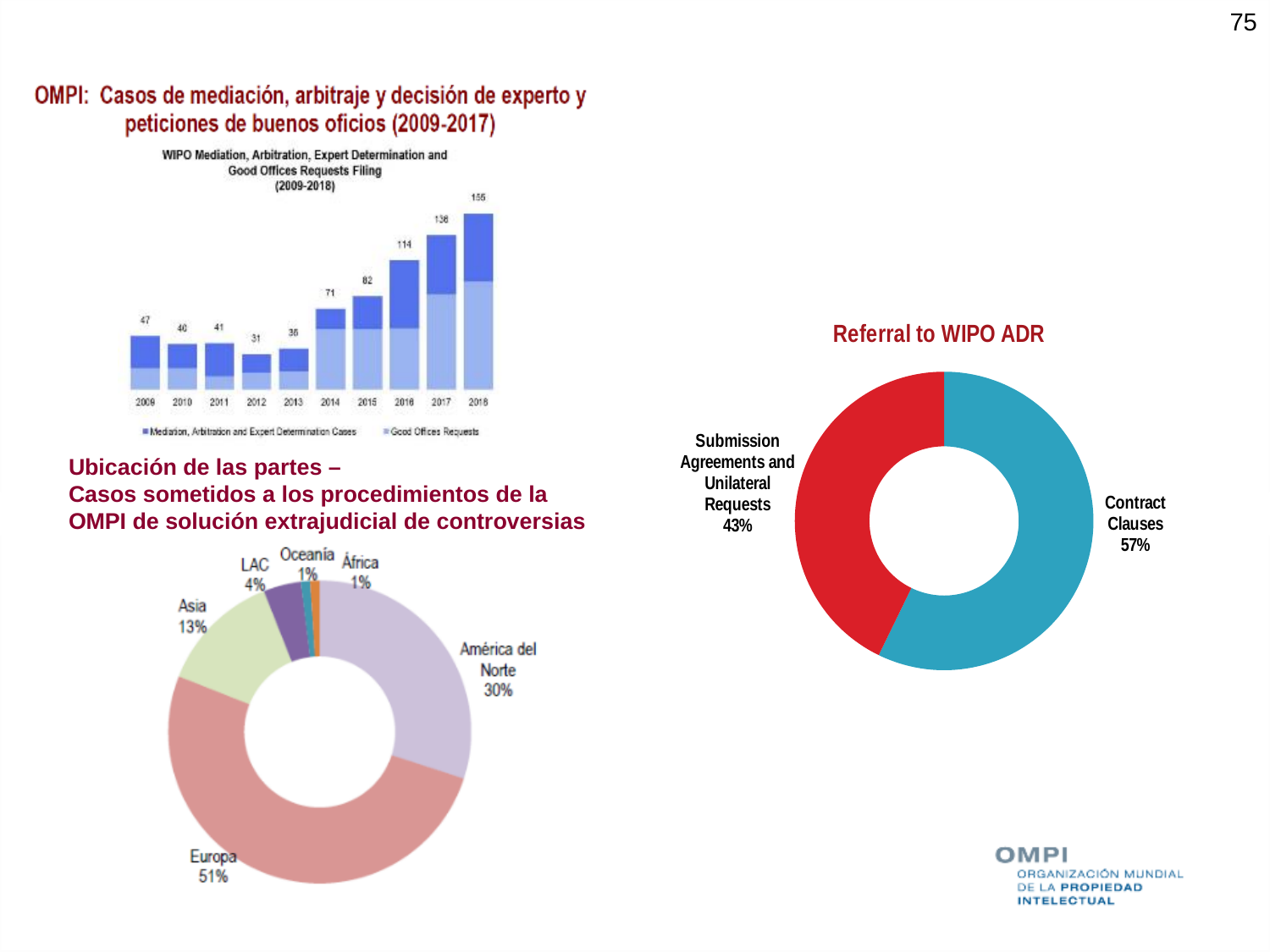
In the bar chart 'WIPO Mediation, Arbitration, Expert Determination and Good Offices Requests Filing (2009-2018)', how many series does the legend list? 2 In the chart 'Referral to WIPO ADR', what share do Contract Clauses have? 57% In the bar chart 'WIPO Mediation, Arbitration, Expert Determination and Good Offices Requests Filing (2009-2018)', what is the difference between the totals for 2017 and 2016? 22 In the bar chart 'WIPO Mediation, Arbitration, Expert Determination and Good Offices Requests Filing (2009-2018)', what is the total value shown for 2012? 31 In the bar chart 'WIPO Mediation, Arbitration, Expert Determination and Good Offices Requests Filing (2009-2018)', how many years are shown on the x axis? 10 In the chart 'Referral to WIPO ADR', which is larger: Contract Clauses or Submission Agreements and Unilateral Requests? Contract Clauses In the donut chart 'Ubicación de las partes', how many regions are shown? 6 In the donut chart 'Ubicación de las partes', what share does Europa have? 51% In the donut chart 'Ubicación de las partes', which region has the largest share? Europa In the bar chart 'WIPO Mediation, Arbitration, Expert Determination and Good Offices Requests Filing (2009-2018)', what is the total value shown for 2018? 155 In the bar chart 'WIPO Mediation, Arbitration, Expert Determination and Good Offices Requests Filing (2009-2018)', do the totals generally rise or fall from 2013 to 2018? rise In the bar chart 'WIPO Mediation, Arbitration, Expert Determination and Good Offices Requests Filing (2009-2018)', which year has the lowest total? 2012